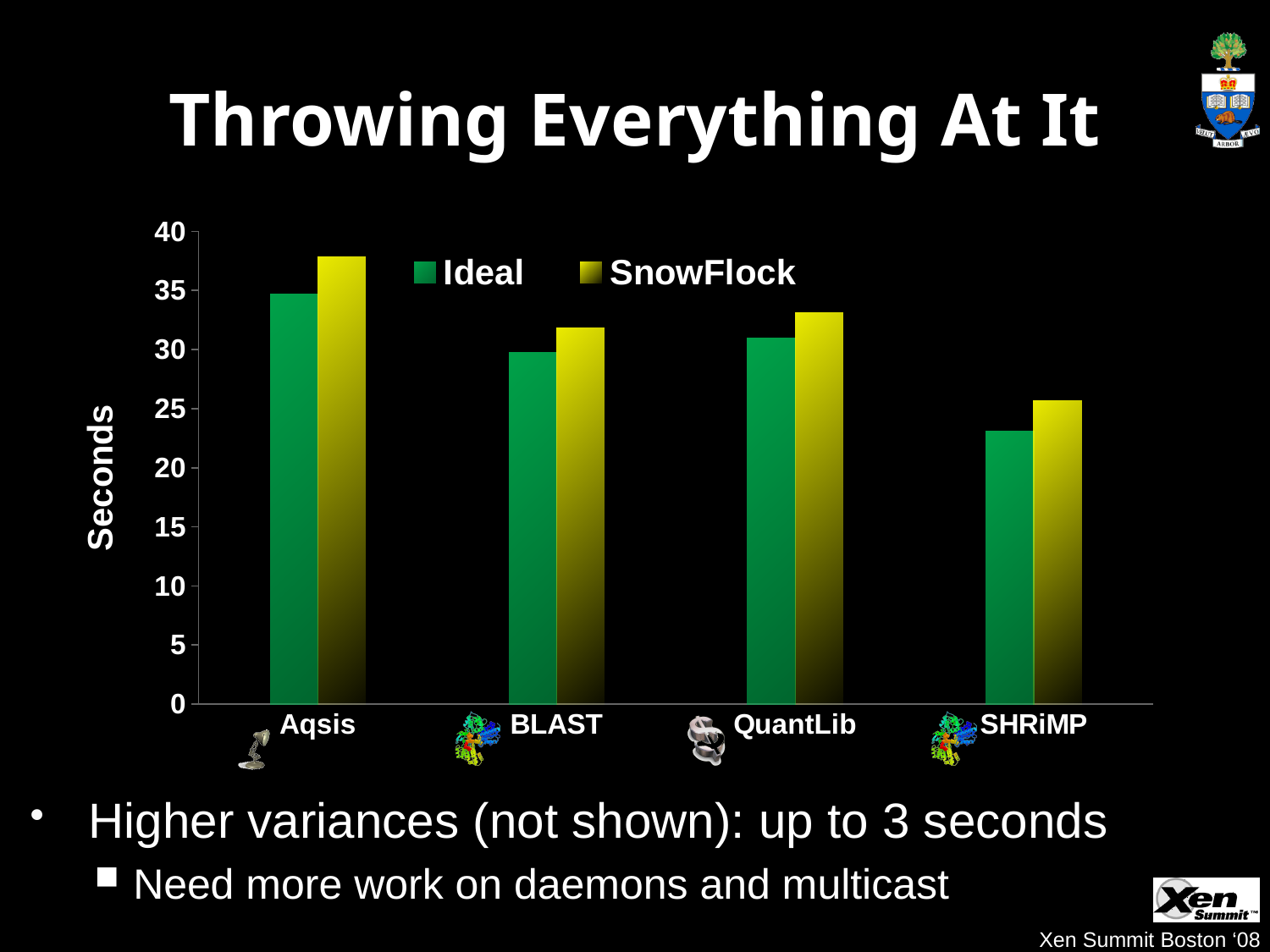
For QuantLib, which is larger: the Ideal value or the SnowFlock value? SnowFlock Is the Ideal value for SHRiMP greater or less than 25? less Which is larger: the Ideal value for Aqsis or the Ideal value for BLAST? Aqsis How many series does the legend list? 2 What kind of chart is shown on the slide? bar chart Which application has the lowest Ideal value? SHRiMP Which application has the highest SnowFlock value? Aqsis Which application has the lowest SnowFlock value? SHRiMP What is the label on the y axis? Seconds Is the SnowFlock value for Aqsis greater or less than 35? greater How many application categories are shown on the x axis? 4